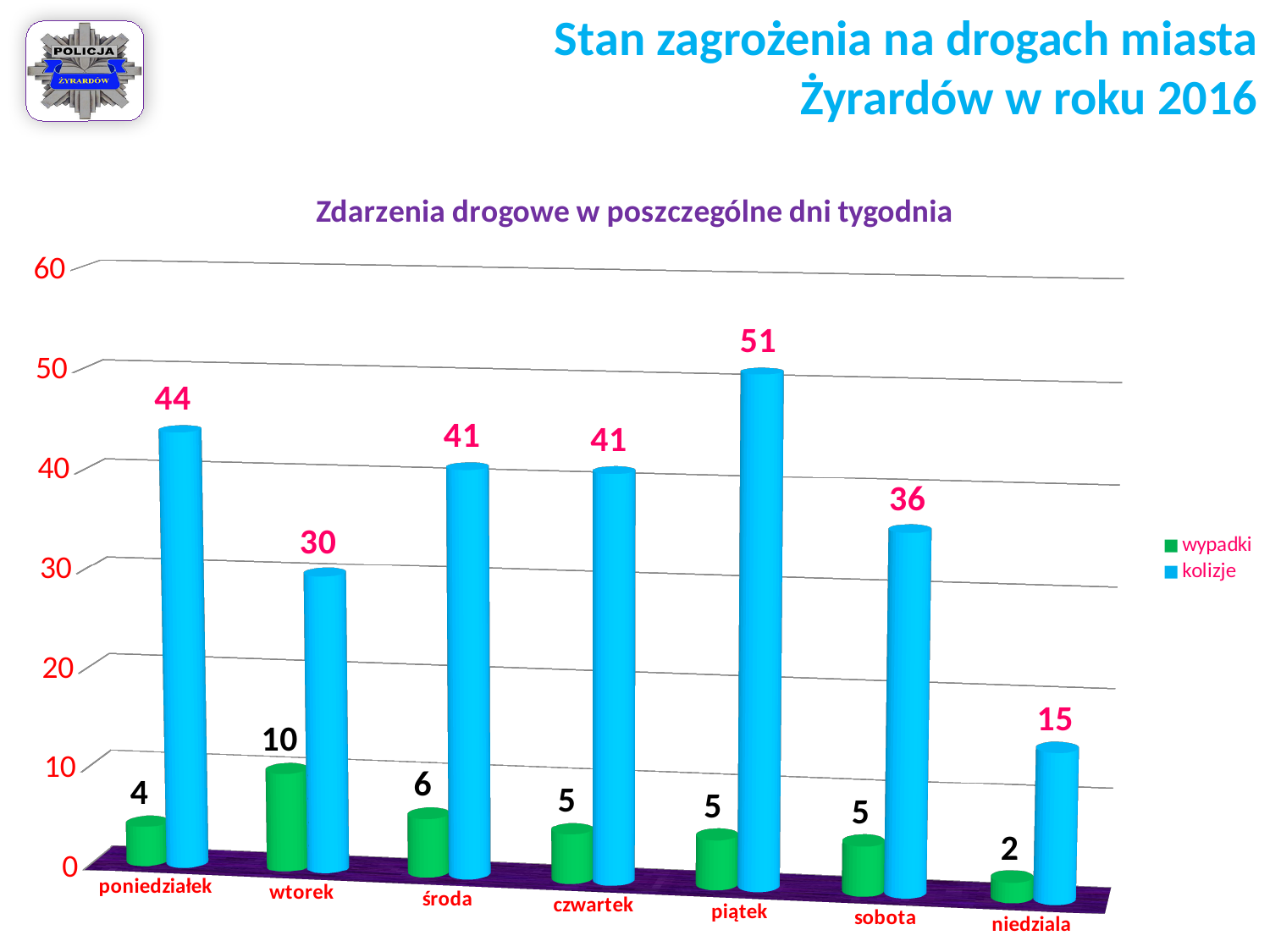
What is the value of kolizje for piątek? 51 What is the value of wypadki for wtorek? 10 Which day has the highest value for kolizje? piątek Which is larger: kolizje for sobota or kolizje for środa? środa How many series does the legend list? 2 What colour are the kolizje bars? blue What is the title of the chart? Zdarzenia drogowe w poszczególne dni tygodnia What kind of chart is shown on the slide? bar chart What is the value of kolizje for niedziala? 15 Which day has the lowest value for wypadki? niedziala How many days are shown on the x axis? 7 What is the difference between kolizje for poniedziałek and kolizje for wtorek? 14